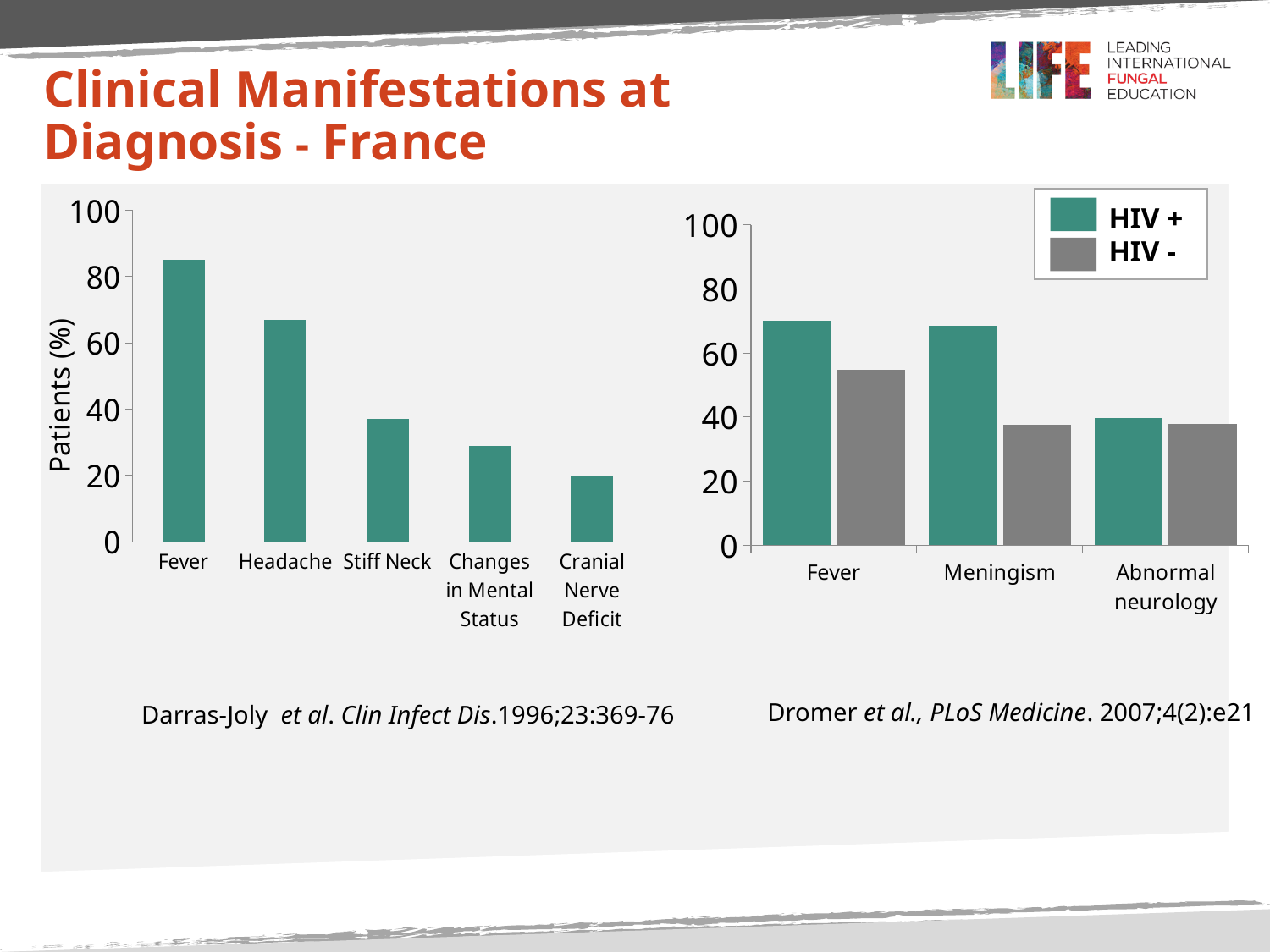
On the right chart, which is larger for Meningism, the HIV + value or the HIV - value? HIV + How many series does the legend of the right chart list? 2 On the left chart, is the value for Stiff Neck greater or less than 40? less What kind of chart is the right chart? bar chart On the left chart, which is larger, the value for Headache or the value for Changes in Mental Status? Headache On the right chart, is the HIV + value for Fever greater or less than 60? greater How many clinical manifestations are shown on the left chart? 5 On the left chart, is the value for Headache greater or less than 60? greater On the left chart, do the values rise or fall from left to right along the x axis? fall On the left chart, which clinical manifestation has the highest percentage of patients? Fever On the left chart, which clinical manifestation has the lowest percentage of patients? Cranial Nerve Deficit